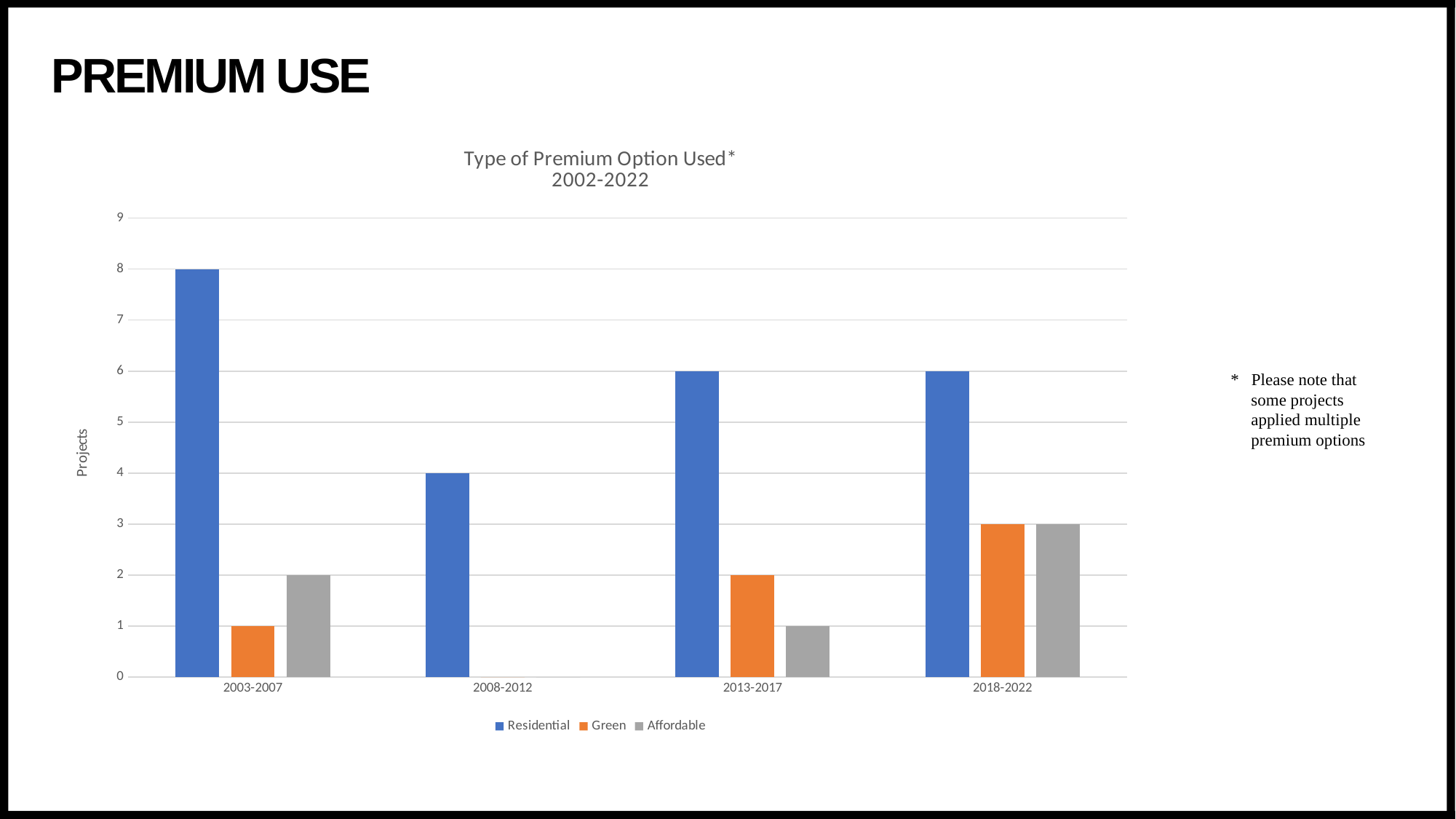
What is the Residential value for 2008-2012? 4 What is the difference between the Residential values for 2003-2007 and 2008-2012? 4 How many period categories are shown on the x axis? 4 Which period has the highest Residential value? 2003-2007 What is the title of the chart? Type of Premium Option Used* 2002-2022 What is the Affordable value for 2013-2017? 1 Which period has the lowest Residential value? 2008-2012 What is the Residential value for 2003-2007? 8 Which is larger, the Green value for 2013-2017 or the Affordable value for 2013-2017? Green How many series does the legend list? 3 What type of chart is shown on the slide? bar chart What is the Green value for 2018-2022? 3